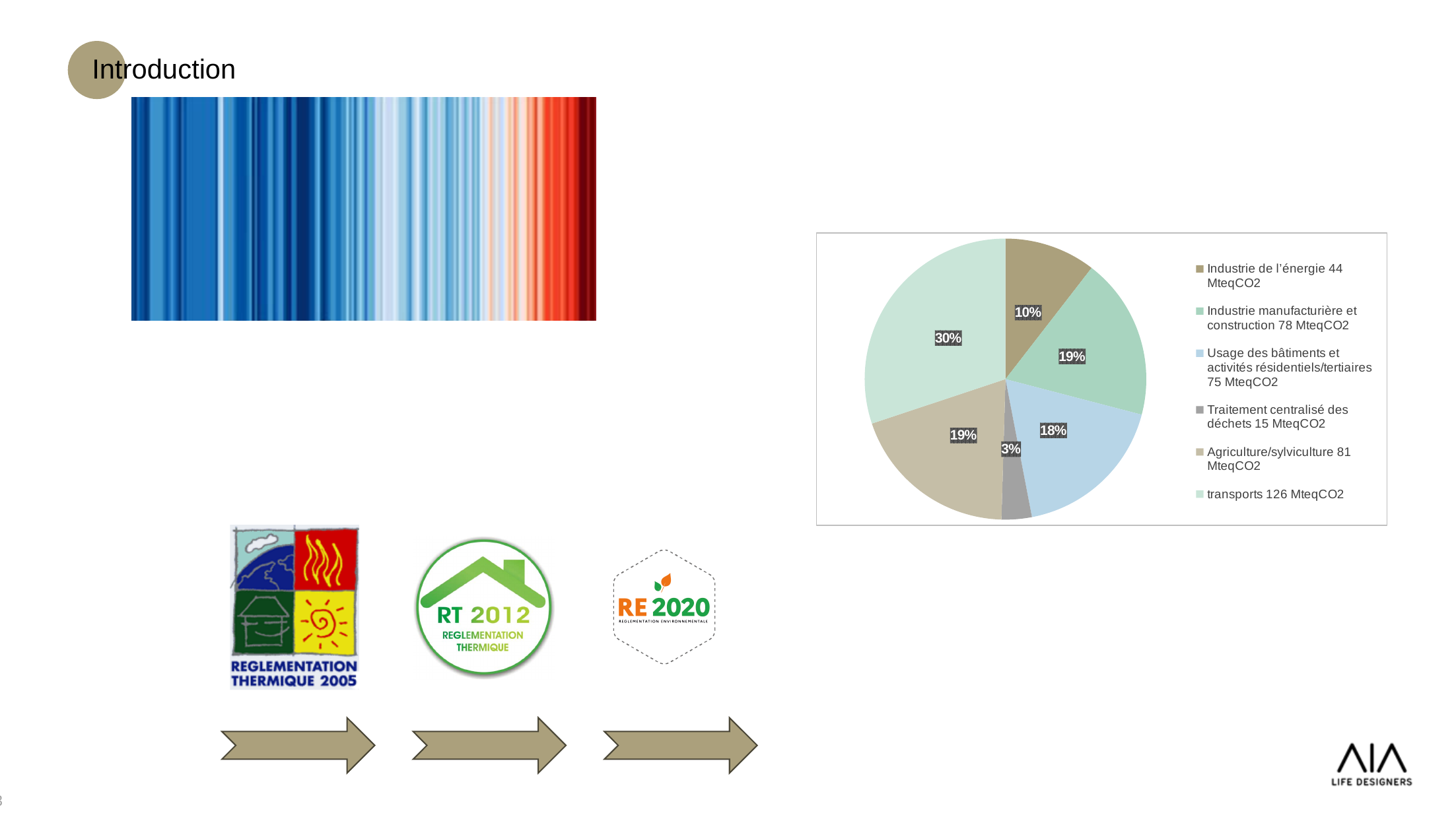
What percentage share does the Usage des bâtiments et activités résidentiels/tertiaires slice have in the pie chart? 18% What percentage share does the Industrie de l'énergie slice have in the pie chart? 10% According to the legend, how many MteqCO2 are attributed to Agriculture/sylviculture? 81 MteqCO2 How many slices does the pie chart have? 6 Which is larger in the pie chart: the share for Usage des bâtiments et activités résidentiels/tertiaires or the share for Industrie de l'énergie? Usage des bâtiments et activités résidentiels/tertiaires Which category has the largest slice in the pie chart? transports What kind of chart is shown on the slide? pie chart According to the legend, how many MteqCO2 are attributed to transports? 126 MteqCO2 Which category has the smallest slice in the pie chart? Traitement centralisé des déchets What percentage share does the Traitement centralisé des déchets slice have in the pie chart? 3% What is the difference in percentage points between the transports slice and the Industrie de l'énergie slice? 20%